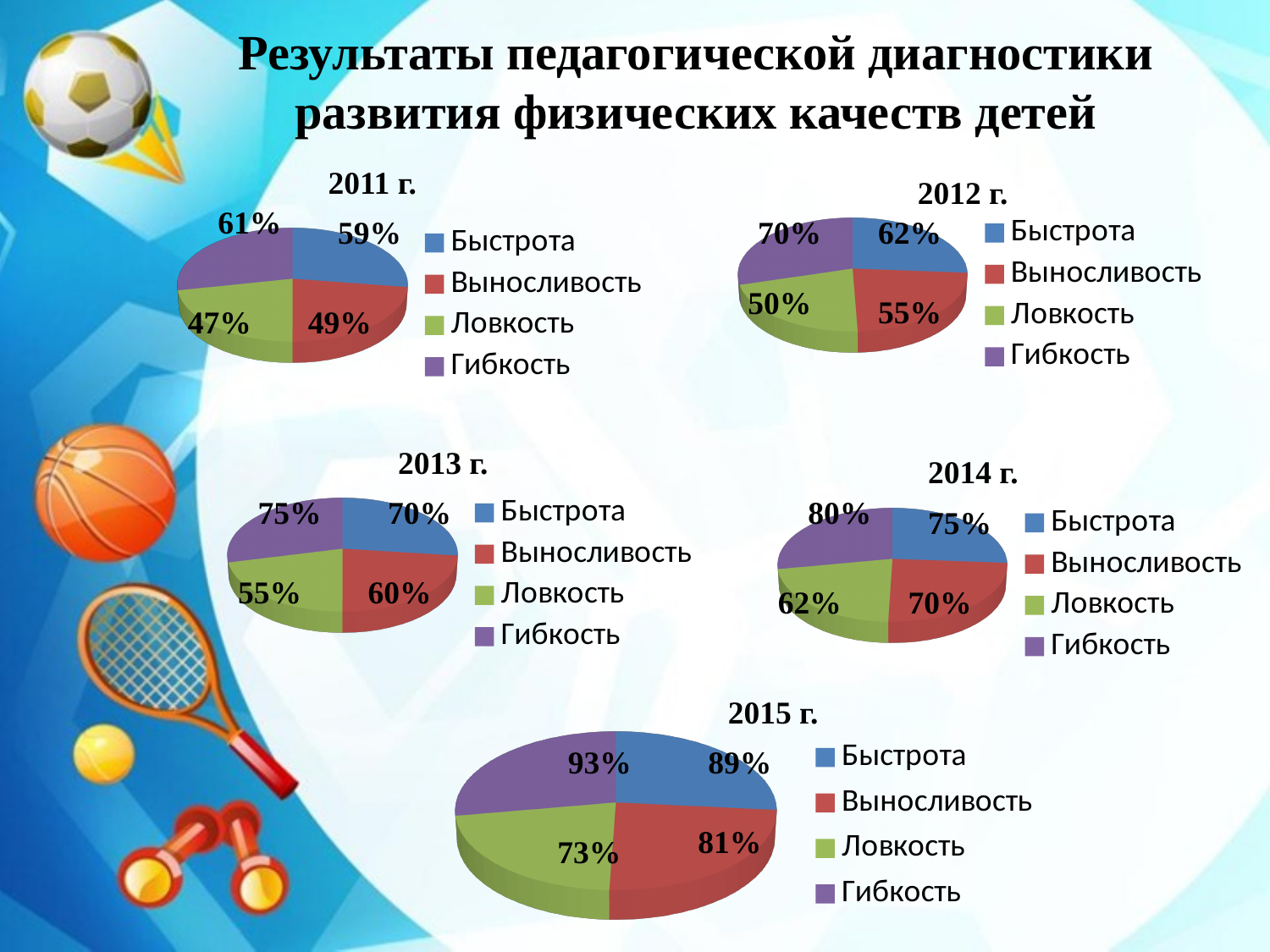
How many categories does the chart titled "2014 г." show? 4 In the chart titled "2012 г.", which is larger, the value for Быстрота or the value for Выносливость? Быстрота What kind of chart is the chart titled "2013 г."? Pie chart In the chart titled "2015 г.", which colour represents Ловкость in the legend? Green In the chart titled "2011 г.", what is the value for Быстрота? 59% In the chart titled "2011 г.", which category has the lowest value? Ловкость In the chart titled "2013 г.", what is the value for Ловкость? 55% In the chart titled "2015 г.", what is the difference between the values for Быстрота and Ловкость? 16% In the chart titled "2015 г.", which category has the highest value? Гибкость How many pie charts are on the slide? 5 In the chart titled "2014 г.", what is the value for Выносливость? 70% In the chart titled "2012 г.", what is the value for Гибкость? 70%